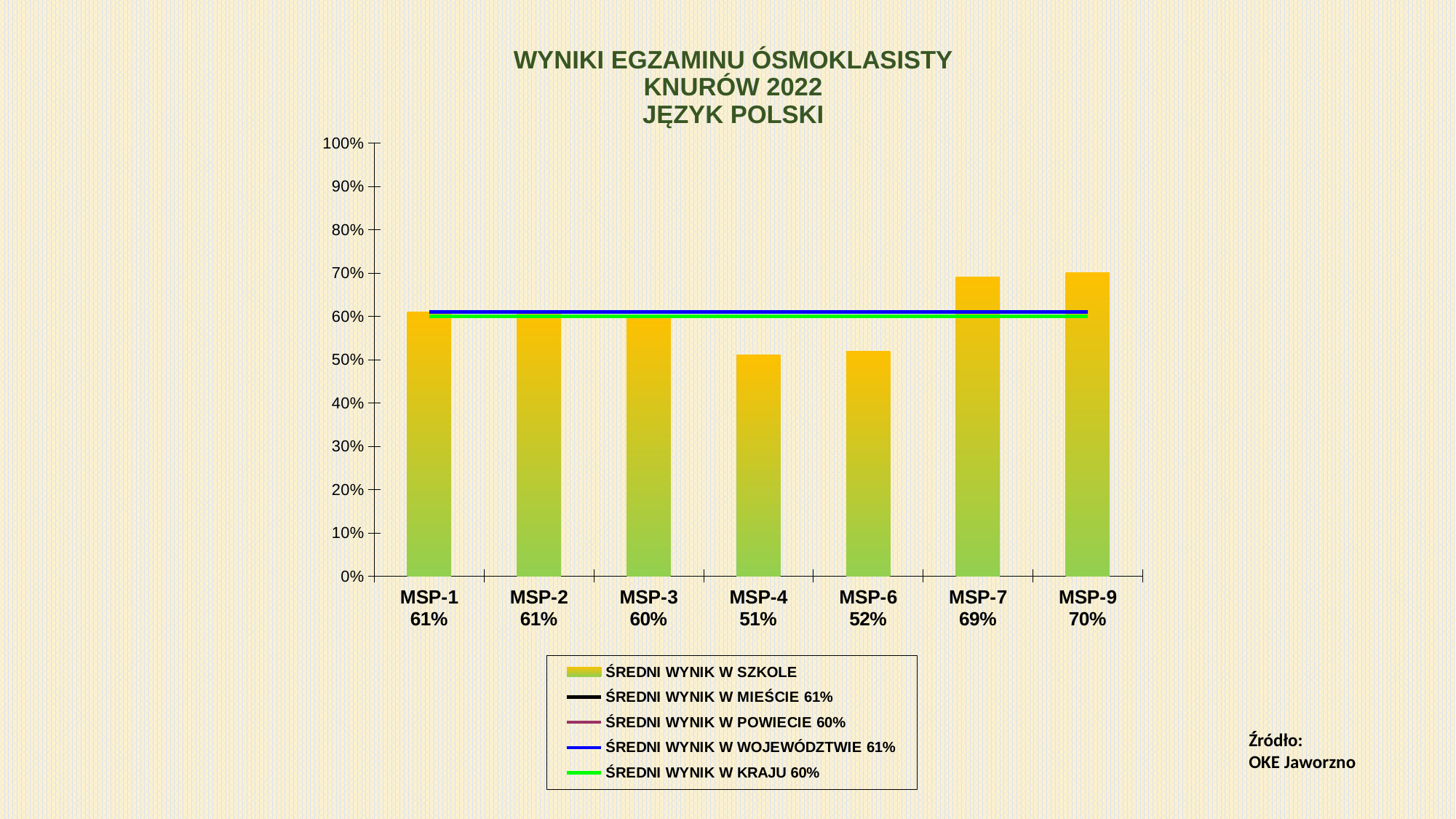
What is the average school result for MSP-3? 60% Which school has the lowest average result? MSP-4 Which school has a higher result, MSP-6 or MSP-7? MSP-7 What kind of chart is shown on the slide? bar chart What subject does the chart title refer to? JĘZYK POLSKI What is the average result in the country (ŚREDNI WYNIK W KRAJU) according to the legend? 60% What is the average school result for MSP-4? 51% What is the difference between the results of MSP-9 and MSP-4? 19% What is the average school result for MSP-7? 69% Which school has the highest average result? MSP-9 How many series does the legend list? 5 How many schools are shown on the x axis? 7